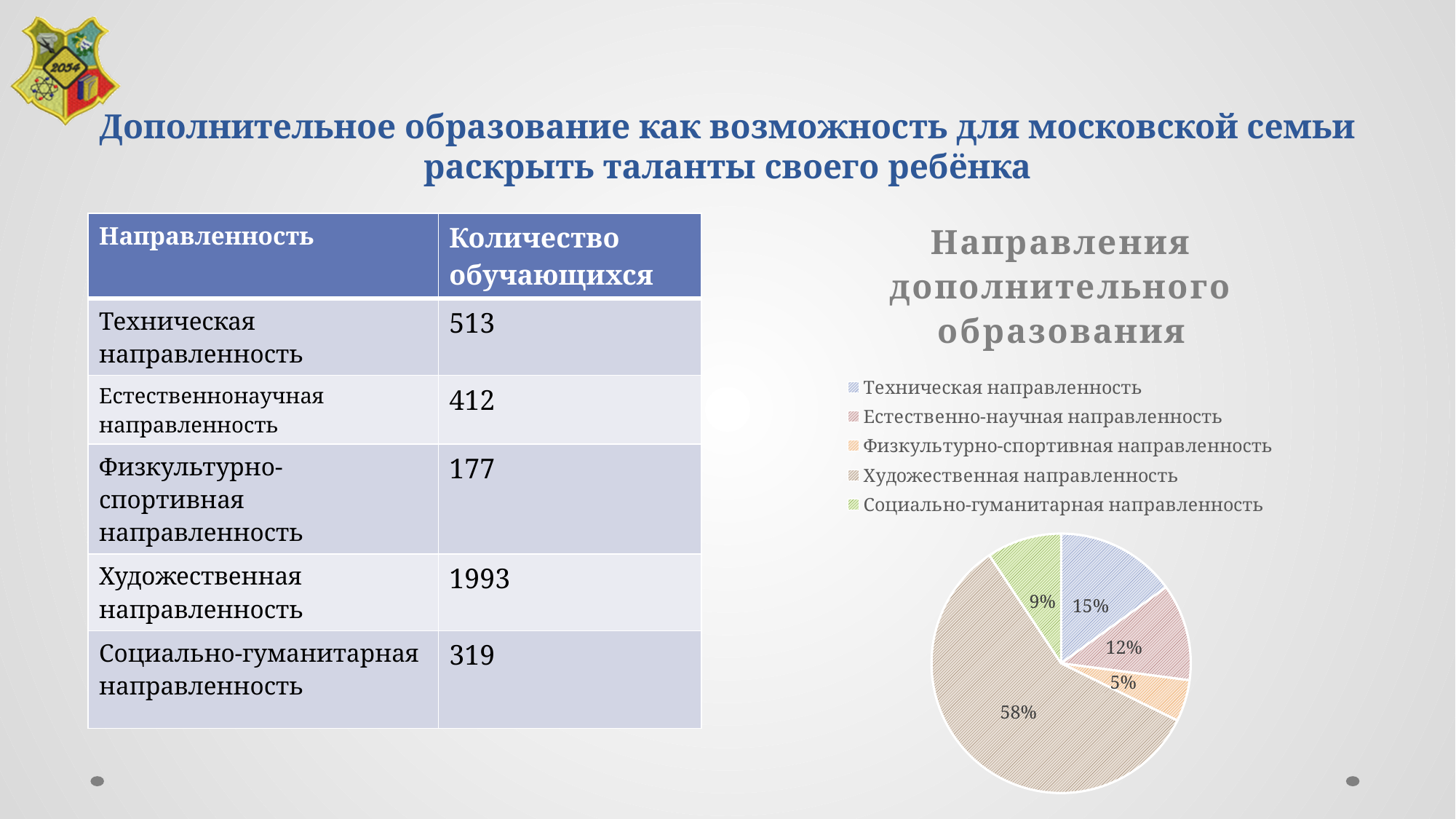
How many entries does the chart legend list? 5 What is the title of the chart on the slide? Направления дополнительного образования Which slice is larger: Техническая направленность or Естественно-научная направленность? Техническая направленность What share of the pie does Техническая направленность have? 15% What share of the pie does Художественная направленность have? 58% Which category has the largest slice of the pie chart? Художественная направленность How many slices does the pie chart have? 5 Which category has the smallest slice of the pie chart? Физкультурно-спортивная направленность What is the difference in percentage points between the Художественная направленность slice and the Техническая направленность slice? 43 What type of chart is shown on the slide? Pie chart What share of the pie does Социально-гуманитарная направленность have? 9%